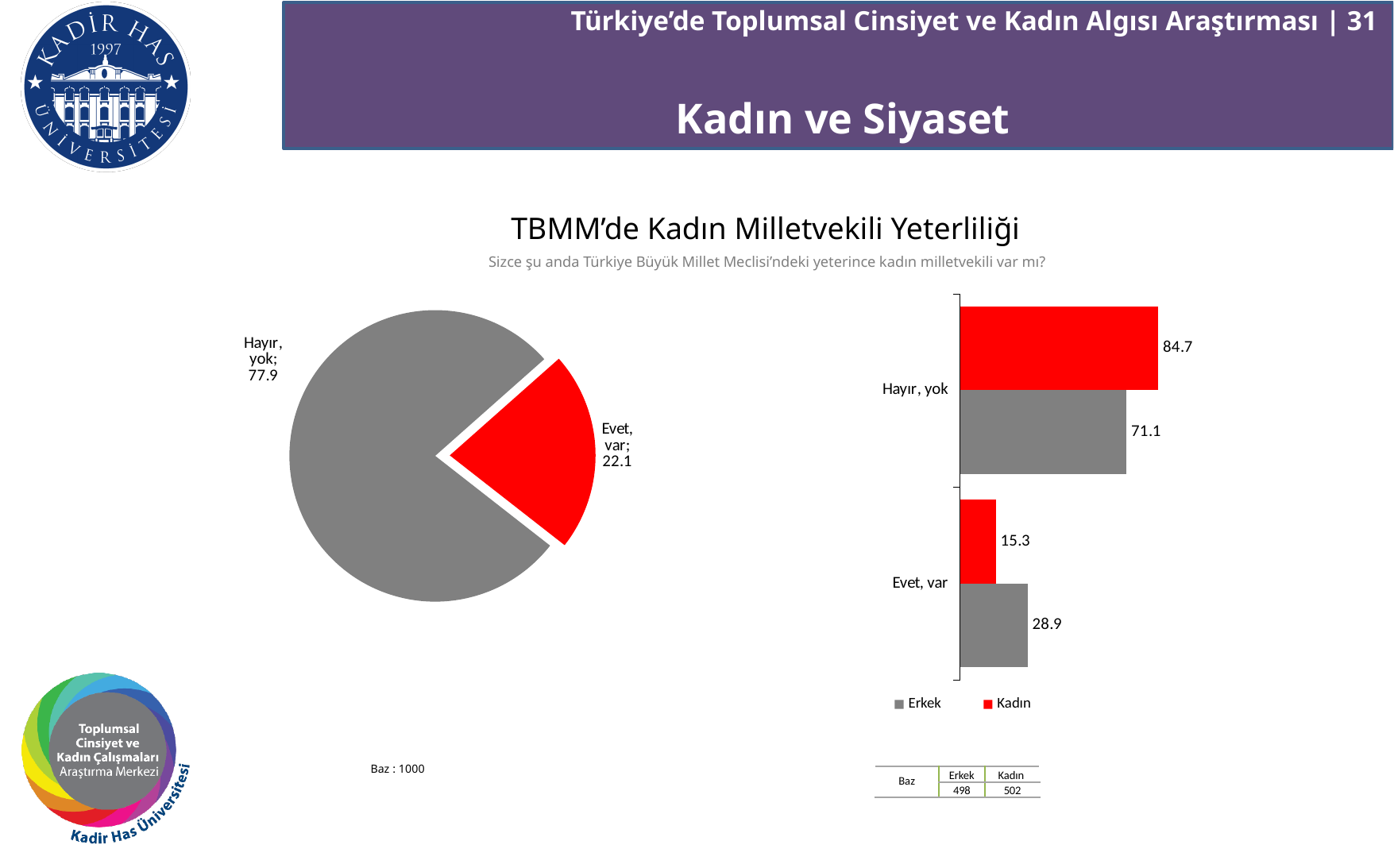
In the bar chart on the right, what is the Erkek value for "Evet, var"? 28.9 In the pie chart on the left, what is the difference between the "Hayır, yok" and "Evet, var" values? 55.8 In the bar chart on the right, what is the Kadın value for "Hayır, yok"? 84.7 In the pie chart on the left, what is the value for "Hayır, yok"? 77.9 In the pie chart on the left, which slice is the largest? Hayır, yok In the bar chart on the right, which colour represents Kadın? Red In the pie chart on the left, what is the value for "Evet, var"? 22.1 How many series does the legend of the bar chart on the right list? 2 What kind of chart is the chart on the right? Bar chart In the bar chart on the right, which is larger for "Hayır, yok": Erkek or Kadın? Kadın What kind of chart is the chart on the left? Pie chart In the bar chart on the right, what is the difference between the Erkek and Kadın values for "Evet, var"? 13.6